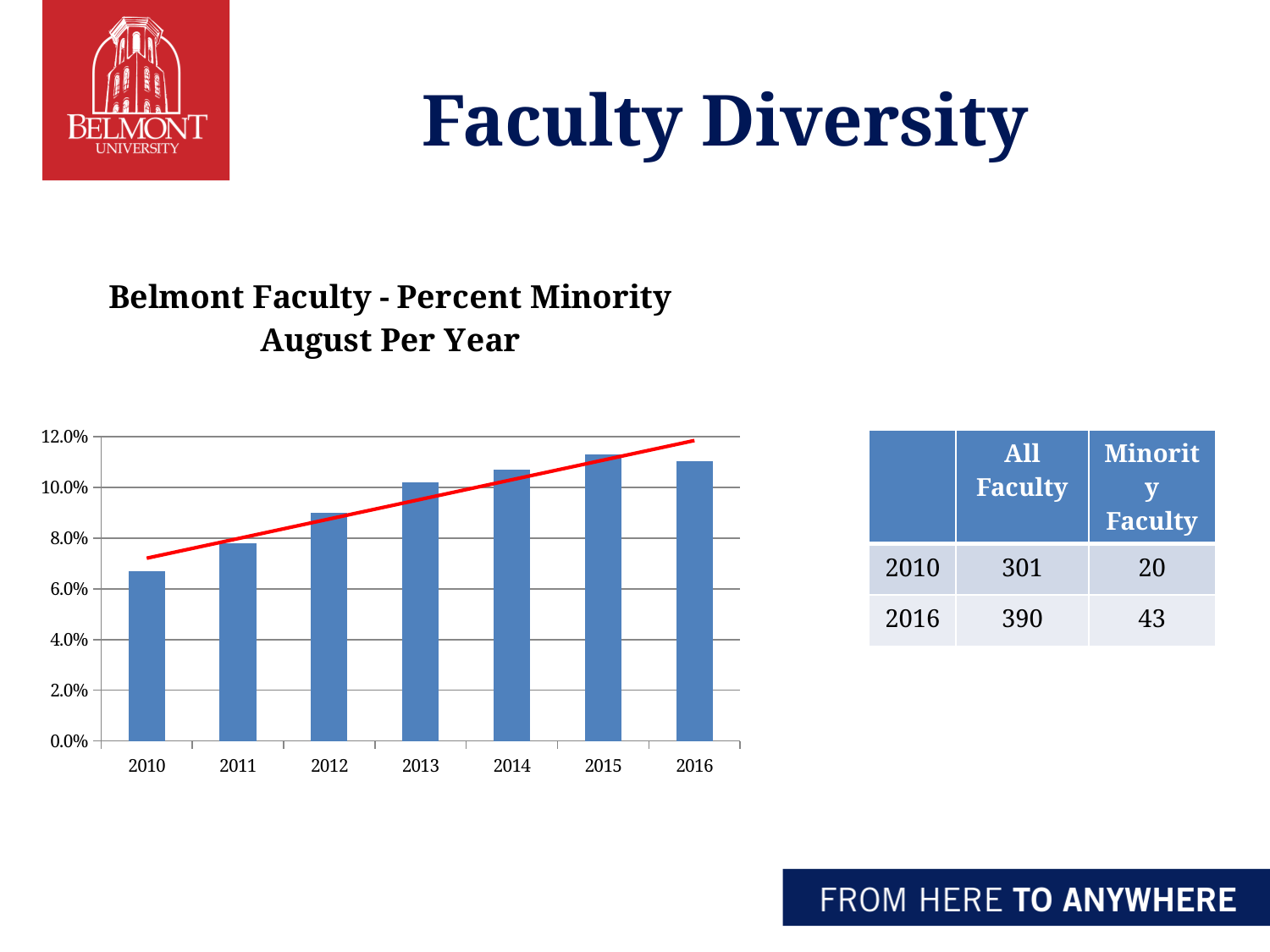
What is the title of the chart? Belmont Faculty - Percent Minority August Per Year What colour is the trend line drawn across the bars? red Is the value for 2016 greater or less than 10.0%? greater Is the value for 2015 greater or less than 10.0%? greater Which year has the highest percent minority faculty in the chart? 2015 Is the value for 2010 greater or less than 8.0%? less What kind of chart is shown on the slide? bar chart Which year has the lowest percent minority faculty in the chart? 2010 How many years are shown on the x axis of the chart? 7 Do the values generally rise or fall from 2010 to 2016? rise Which year has a larger value, 2010 or 2013? 2013